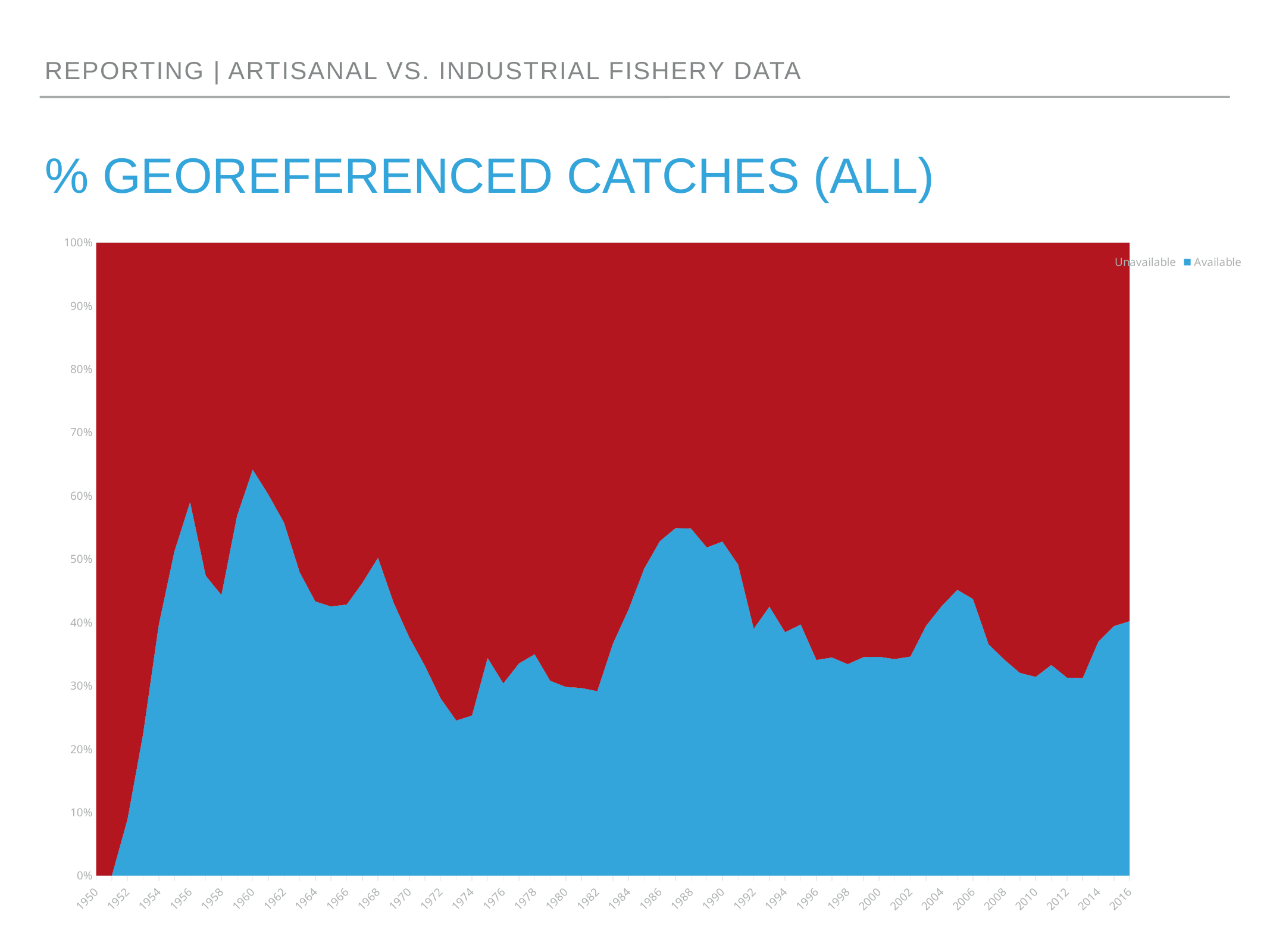
What kind of chart is shown on the slide? Stacked area chart What are the two series named in the legend? Unavailable and Available In which year does the Available share reach its highest point? 1960 Is the Available share in 1988 greater or less than 50%? greater Is the Available share in 2016 greater or less than 50%? less Which colour represents the Available series? Blue Is the Available share in 1973 greater or less than 30%? less How many series does the legend list? 2 Which is larger in 1988, the Available share or the Unavailable share? Available Does the Available share rise or fall between 1950 and 1956? Rise